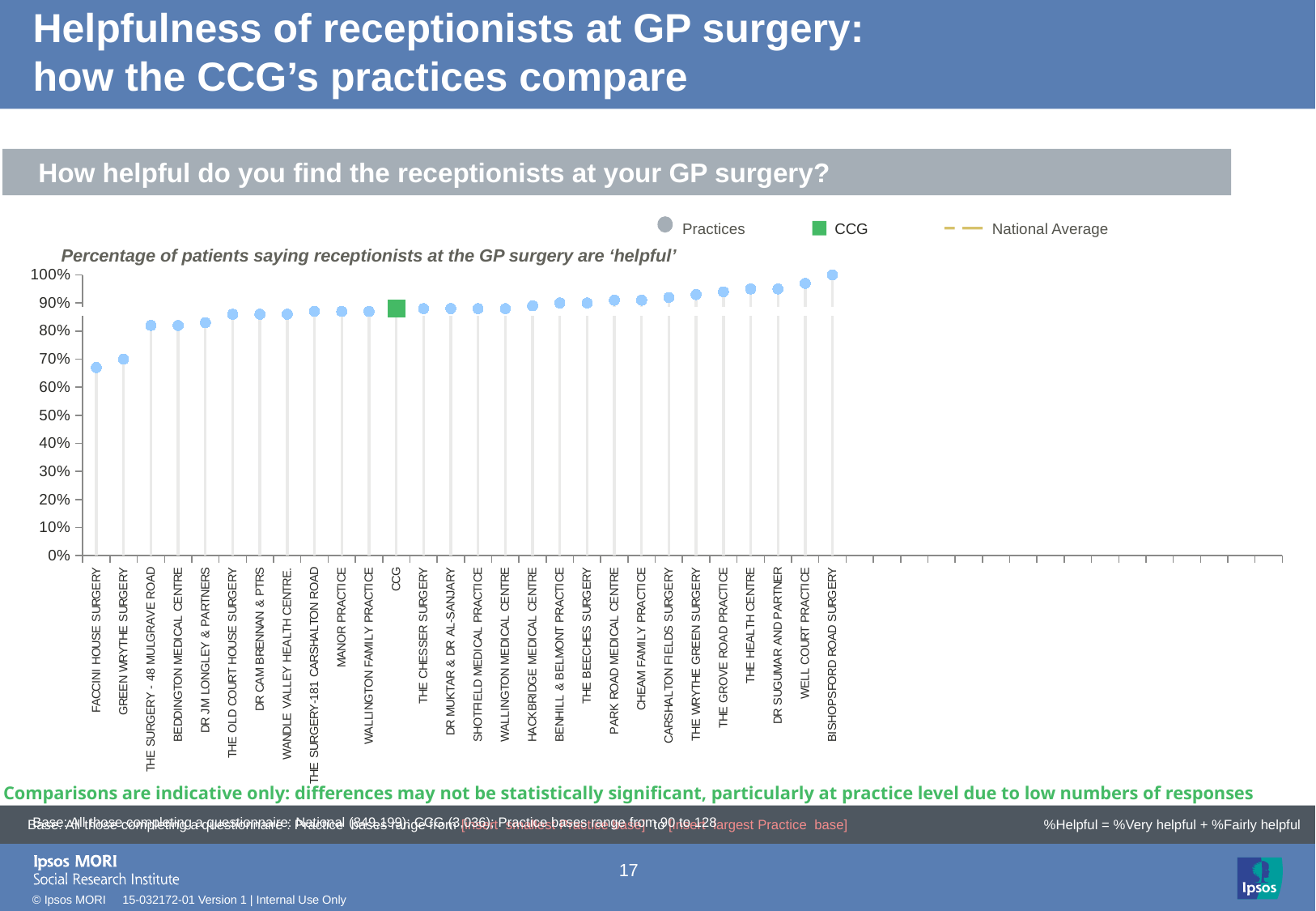
Which has a higher value, WELL COURT PRACTICE or GREEN WRYTHE SURGERY? WELL COURT PRACTICE Do the values rise or fall from left to right along the x axis? rise How many entries does the legend list? 3 Is the value for CCG greater or less than 80%? greater How many categories (including CCG) are plotted along the x axis? 28 Which practice has the lowest percentage of patients saying receptionists are 'helpful'? FACCINI HOUSE SURGERY What colour is the CCG marker in the legend? green Which practice has the highest percentage of patients saying receptionists are 'helpful'? BISHOPSFORD ROAD SURGERY Is the value for GREEN WRYTHE SURGERY greater or less than 80%? less Is the value for FACCINI HOUSE SURGERY greater or less than 60%? greater Which has a higher value, BISHOPSFORD ROAD SURGERY or FACCINI HOUSE SURGERY? BISHOPSFORD ROAD SURGERY